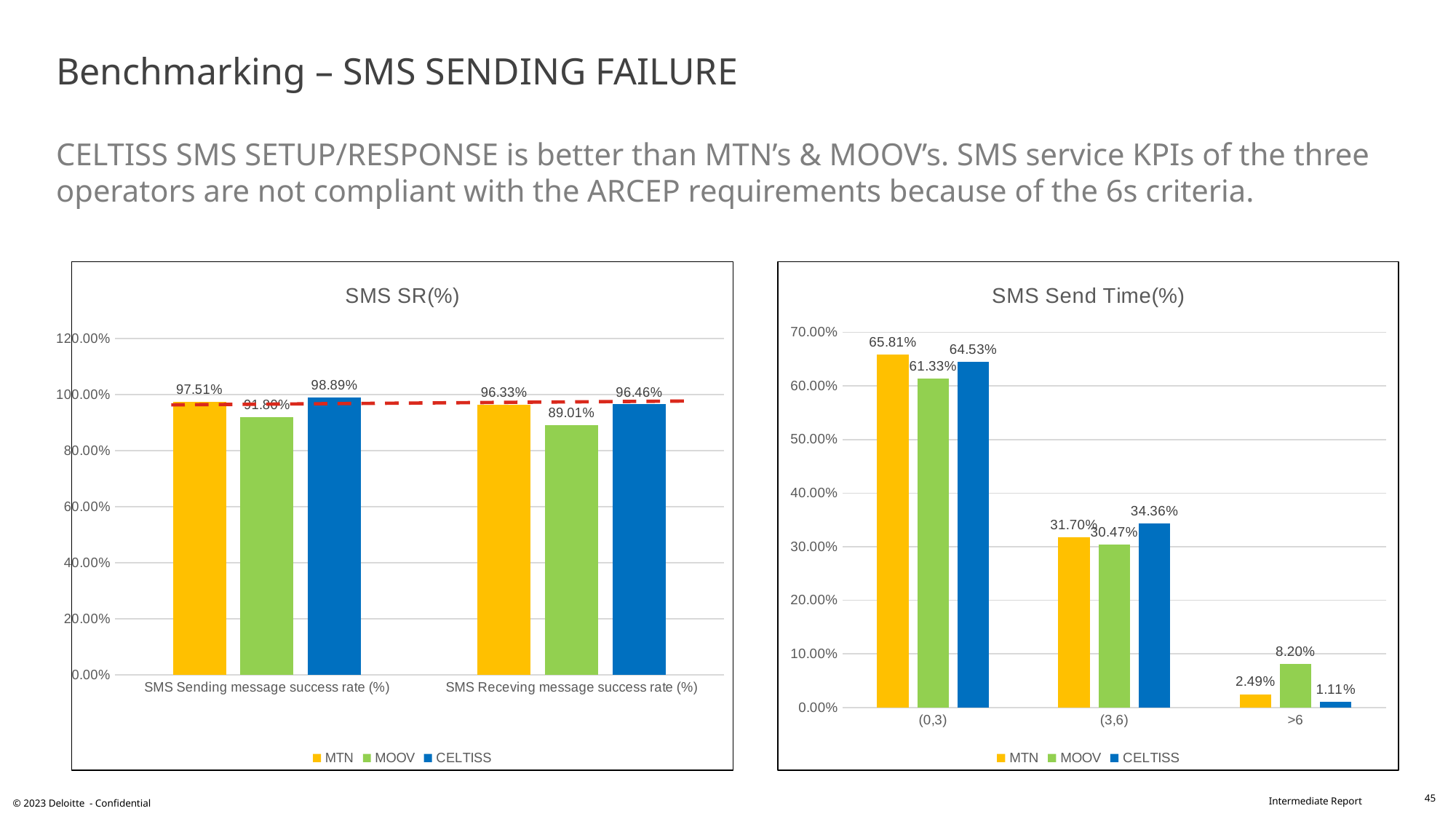
In the SMS Send Time(%) chart, what is the value for CELTISS in the >6 category? 1.11% In the SMS SR(%) chart, what is the difference between MTN's and MOOV's SMS Receving message success rate? 7.32% In the SMS Send Time(%) chart, what is the value for MOOV in the (0,3) category? 61.33% In the SMS SR(%) chart, which operator has the lowest SMS Receving message success rate? MOOV In the SMS SR(%) chart, what is the SMS Receving message success rate for MOOV? 89.01% In the SMS Send Time(%) chart, what is the difference between MOOV's and MTN's values in the >6 category? 5.71% In the SMS SR(%) chart, which operator has the highest SMS Sending message success rate? CELTISS In the SMS Send Time(%) chart, how many categories are shown on the x axis? 3 What kind of chart is the SMS Send Time(%) chart? Bar chart In the SMS SR(%) chart, what is the SMS Sending message success rate for CELTISS? 98.89% In the SMS SR(%) chart, how many series does the legend list? 3 In the SMS Send Time(%) chart, which operator has the highest value in the (3,6) category? CELTISS